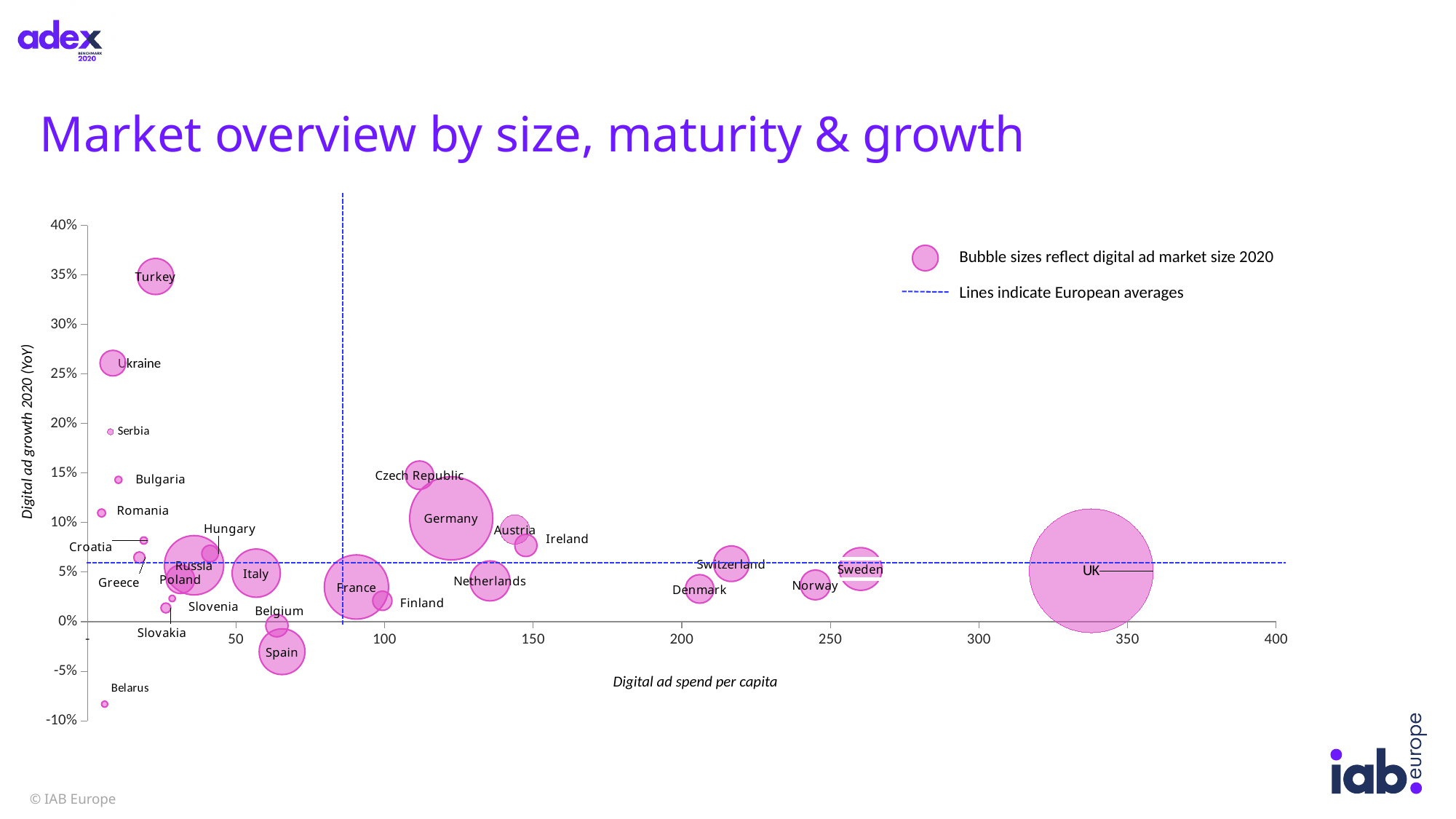
Which country has the largest bubble, i.e. the largest digital ad market size 2020? UK According to the legend, what do the bubble sizes reflect? Digital ad market size 2020 Which has the higher digital ad spend per capita, Germany or the UK? UK What kind of chart is shown on the slide? Bubble chart Is the digital ad growth for Spain greater or less than 0%? less Which country has the highest digital ad spend per capita? UK Is the digital ad growth for Turkey greater or less than 30%? greater Which has the higher digital ad growth 2020, Turkey or Ukraine? Turkey Which country has the lowest digital ad growth 2020 (YoY)? Belarus Which country has the highest digital ad growth 2020 (YoY)? Turkey Is the digital ad spend per capita for the UK greater or less than 300? greater